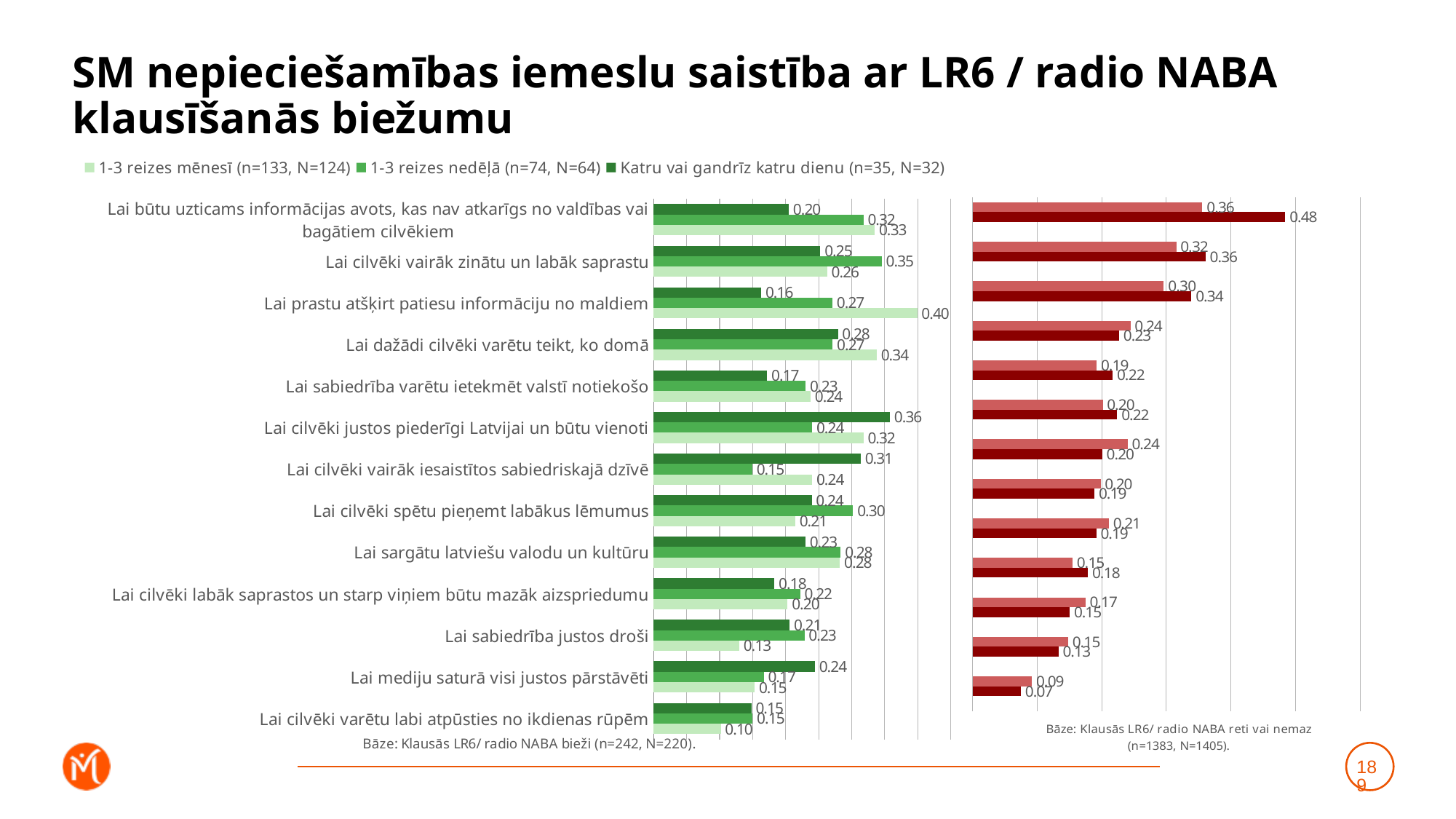
In the left (green) chart, what is the value for 'Katru vai gandrīz katru dienu' for 'Lai cilvēki justos piederīgi Latvijai un būtu vienoti'? 0.36 In the left (green) chart, for 'Lai sabiedrība justos droši', which is larger: '1-3 reizes nedēļā' or '1-3 reizes mēnesī'? 1-3 reizes nedēļā In the left (green) chart, what is the value for '1-3 reizes nedēļā' for 'Lai cilvēki spētu pieņemt labākus lēmumus'? 0.30 In the left (green) chart, which category has the lowest value for '1-3 reizes mēnesī'? Lai cilvēki varētu labi atpūsties no ikdienas rūpēm In the left (green) chart, what is the difference between 'Katru vai gandrīz katru dienu' and '1-3 reizes nedēļā' for 'Lai cilvēki vairāk iesaistītos sabiedriskajā dzīvē'? 0.16 What kind of chart is used on this slide? Bar chart In the left (green) chart, which category has the highest value for '1-3 reizes mēnesī'? Lai prastu atšķirt patiesu informāciju no maldiem What base (Bāze) is stated below the left (green) chart? Klausās LR6/ radio NABA bieži (n=242, N=220) In the right (red) chart, what is the highest value shown? 0.48 In the left (green) chart, how many series does the legend list? 3 In the left (green) chart, how many categories (reasons) are plotted? 13 In the left (green) chart, what is the value for '1-3 reizes mēnesī' for 'Lai prastu atšķirt patiesu informāciju no maldiem'? 0.40